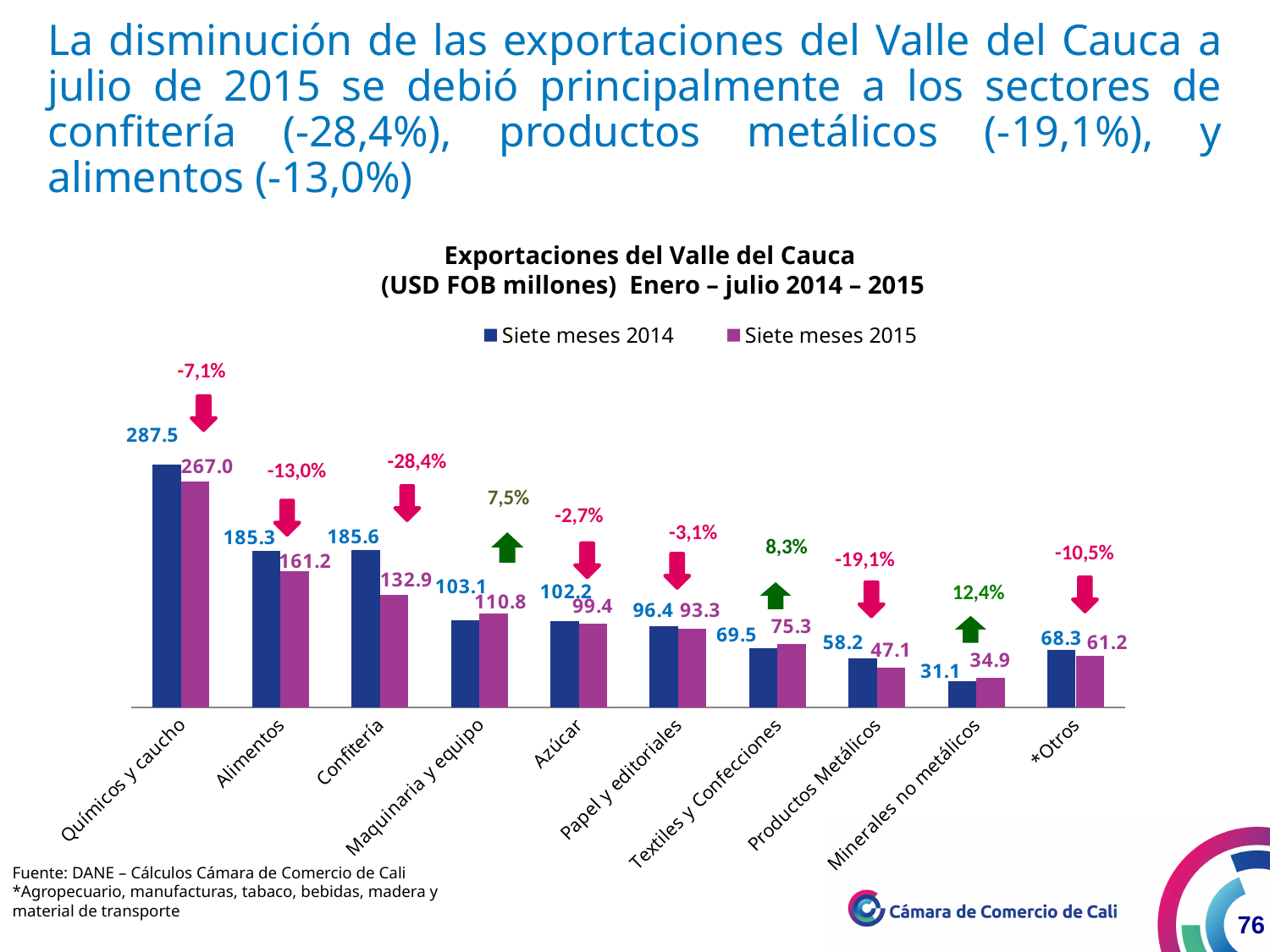
How many series does the legend list? 2 Which category has the lowest value in the Siete meses 2015 series? Minerales no metálicos Which is larger for Maquinaria y equipo: the Siete meses 2014 value or the Siete meses 2015 value? Siete meses 2015 What is the title of the chart? Exportaciones del Valle del Cauca (USD FOB millones) Enero – julio 2014 – 2015 What kind of chart is shown on the slide? Bar chart How many categories are shown on the x axis? 10 Which category has the highest value in the Siete meses 2014 series? Químicos y caucho What percentage change is shown above the bars for Productos Metálicos? -19,1% What is the value for Minerales no metálicos in the Siete meses 2015 series? 34.9 What is the value for Químicos y caucho in the Siete meses 2014 series? 287.5 What is the difference between the Siete meses 2014 and Siete meses 2015 values for Alimentos? 24.1 What is the value for Confitería in the Siete meses 2015 series? 132.9